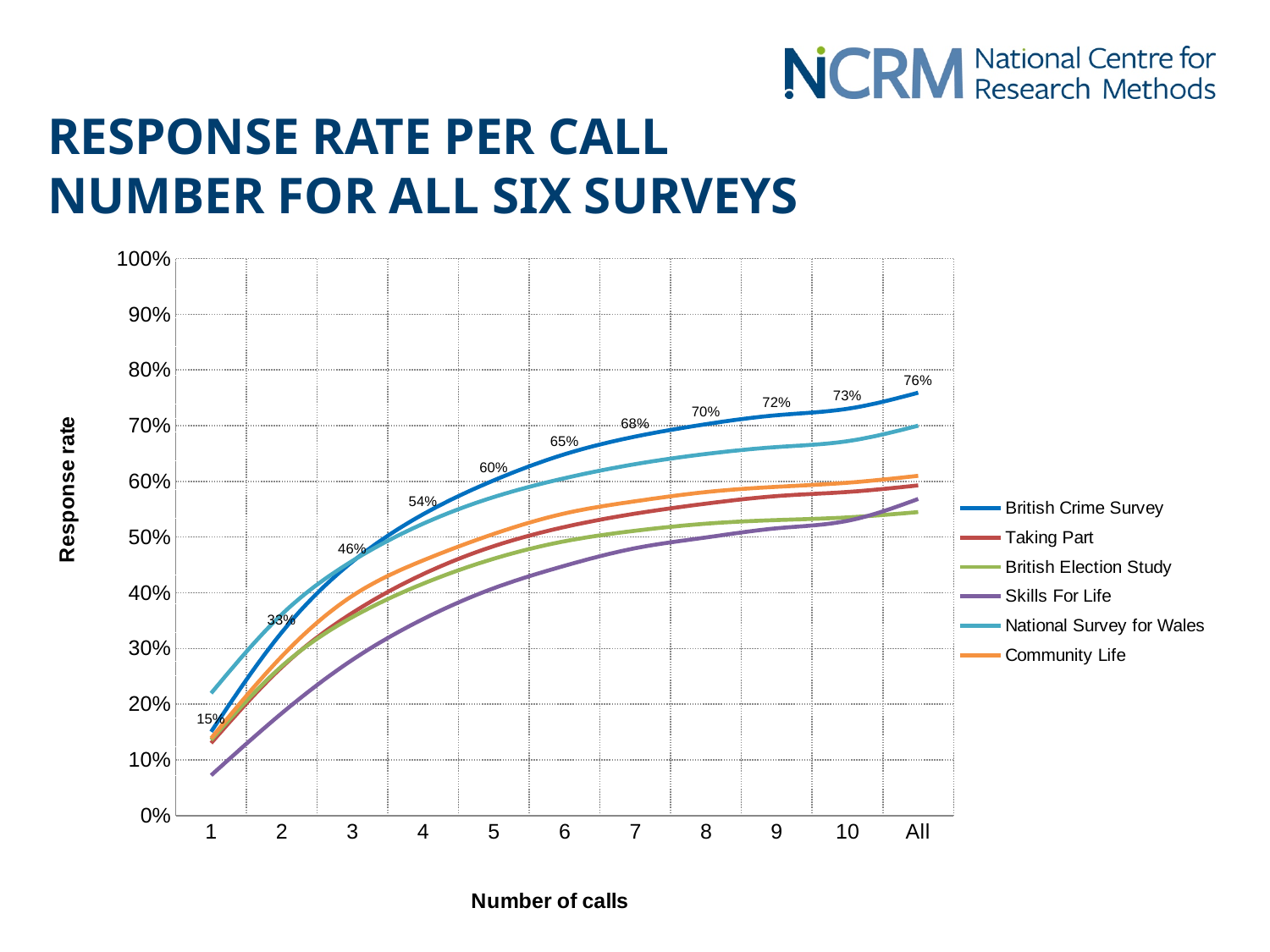
At call number 1, which has the higher response rate: National Survey for Wales or British Crime Survey? National Survey for Wales What is the response rate for the British Crime Survey at call number 5? 60% How many series does the legend list? 6 Which survey has the highest response rate at 'All' calls? British Crime Survey Is the response rate for Skills For Life at call number 1 greater or less than 10%? less Do the response rates rise or fall as the number of calls increases? Rise Which survey has the lowest response rate at call number 1? Skills For Life What is the response rate for the British Crime Survey at call number 1? 15% What kind of chart is shown on the slide? Line chart By how many percentage points does the British Crime Survey response rate increase from call 1 to 'All'? 61 percentage points What is the response rate for the British Crime Survey at 'All' calls? 76% Is the response rate for the British Election Study at 'All' calls greater or less than 60%? less